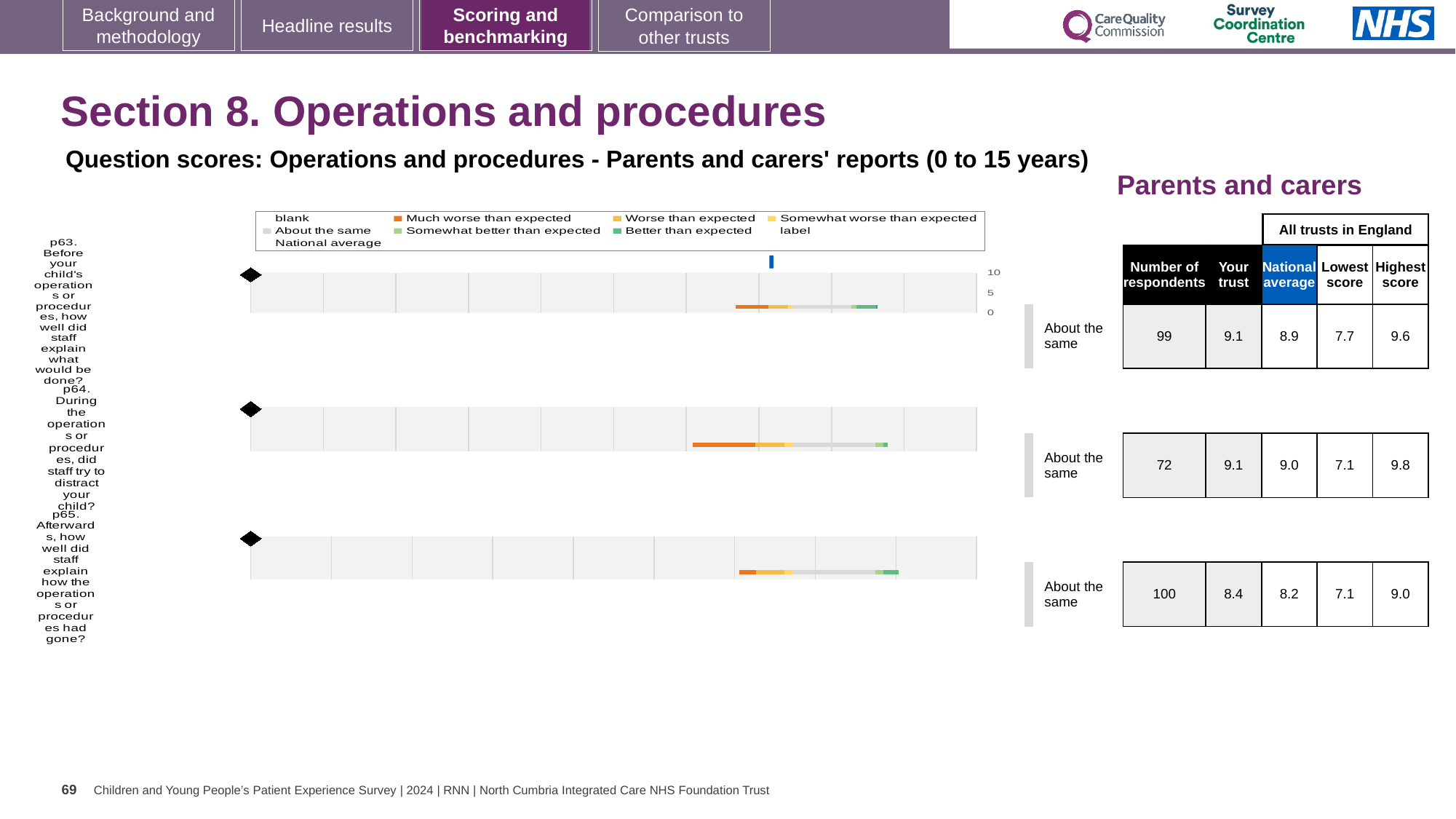
What kind of chart is used to show the benchmark bands for p63, p64 and p65? bar chart What is the national average score for p65 (Afterwards, how well did staff explain how the operations or procedures had gone?)? 8.2 What is the difference between the 'Your trust' score and the national average for p64? 0.1 How many questions (p63 to p65) have a benchmark bar chart on the slide? 3 Is the 'Your trust' score for p65 higher or lower than the national average for p65? higher What is the 'Your trust' score for p63 (Before your child's operations or procedures, how well did staff explain what would be done?)? 9.1 What benchmark category label is shown for all three questions? About the same Which colour in the legend represents 'Much worse than expected'? orange What is the highest score across all trusts in England for p63? 9.6 How many respondents answered p64 (During the operations or procedures, did staff try to distract your child?)? 72 Which of the three questions has the lowest 'Your trust' score? p65 What is the difference between the highest score and the lowest score for p64? 2.7